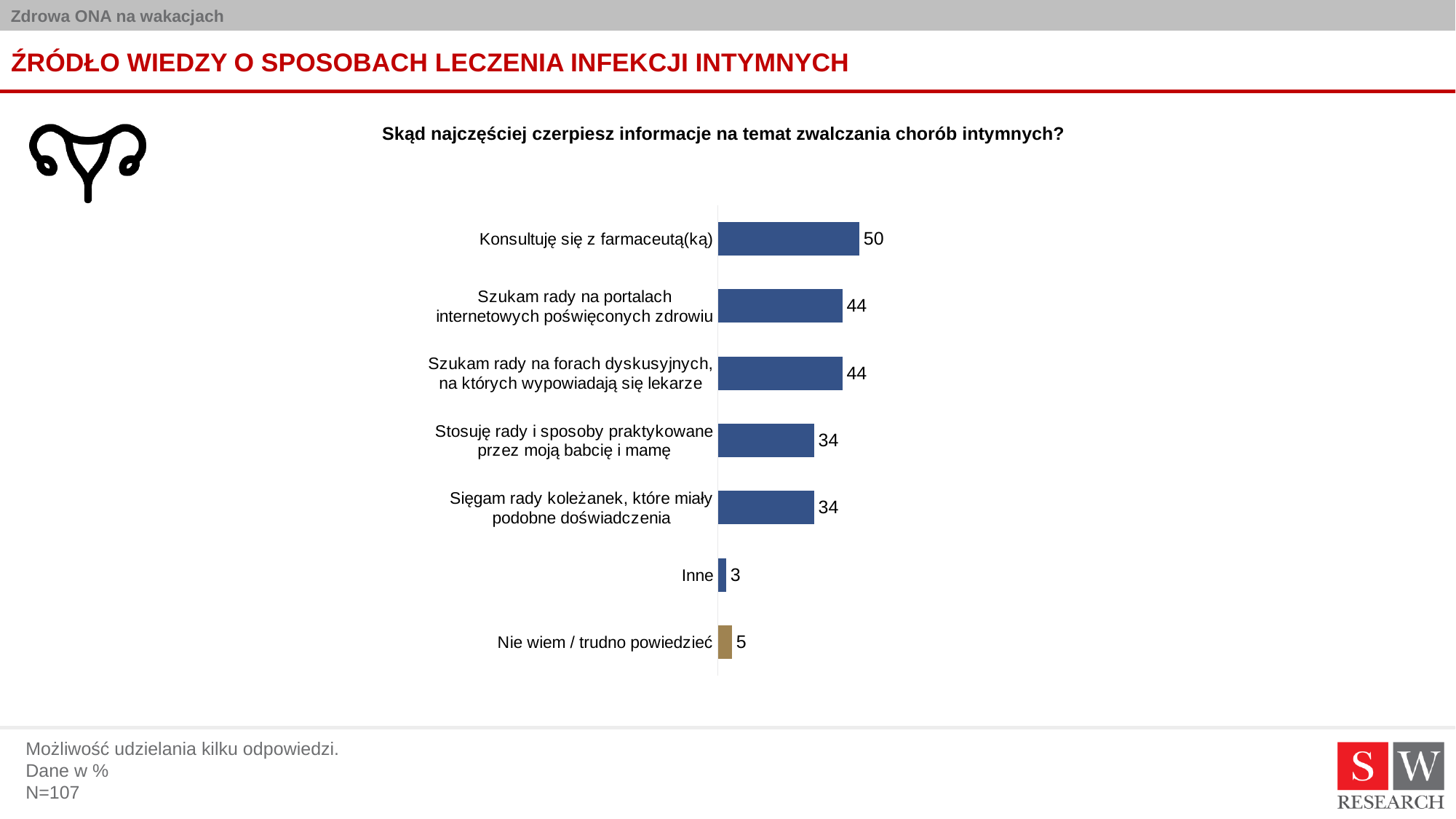
How many categories are shown in the chart? 7 What is the difference between the values for "Nie wiem / trudno powiedzieć" and "Inne"? 2 What is the value for "Konsultuję się z farmaceutą(ką)"? 50 Which category has the highest value? Konsultuję się z farmaceutą(ką) Which category has the lowest value? Inne Which category's bar is shown in a different colour from the others? Nie wiem / trudno powiedzieć What is the value for "Inne"? 3 Which is larger: the value for "Szukam rady na forach dyskusyjnych, na których wypowiadają się lekarze" or the value for "Sięgam rady koleżanek, które miały podobne doświadczenia"? Szukam rady na forach dyskusyjnych, na których wypowiadają się lekarze What is the difference between the values for "Konsultuję się z farmaceutą(ką)" and "Szukam rady na portalach internetowych poświęconych zdrowiu"? 6 What is the value for "Stosuję rady i sposoby praktykowane przez moją babcię i mamę"? 34 What is the value for "Nie wiem / trudno powiedzieć"? 5 What kind of chart is shown on the slide? Bar chart